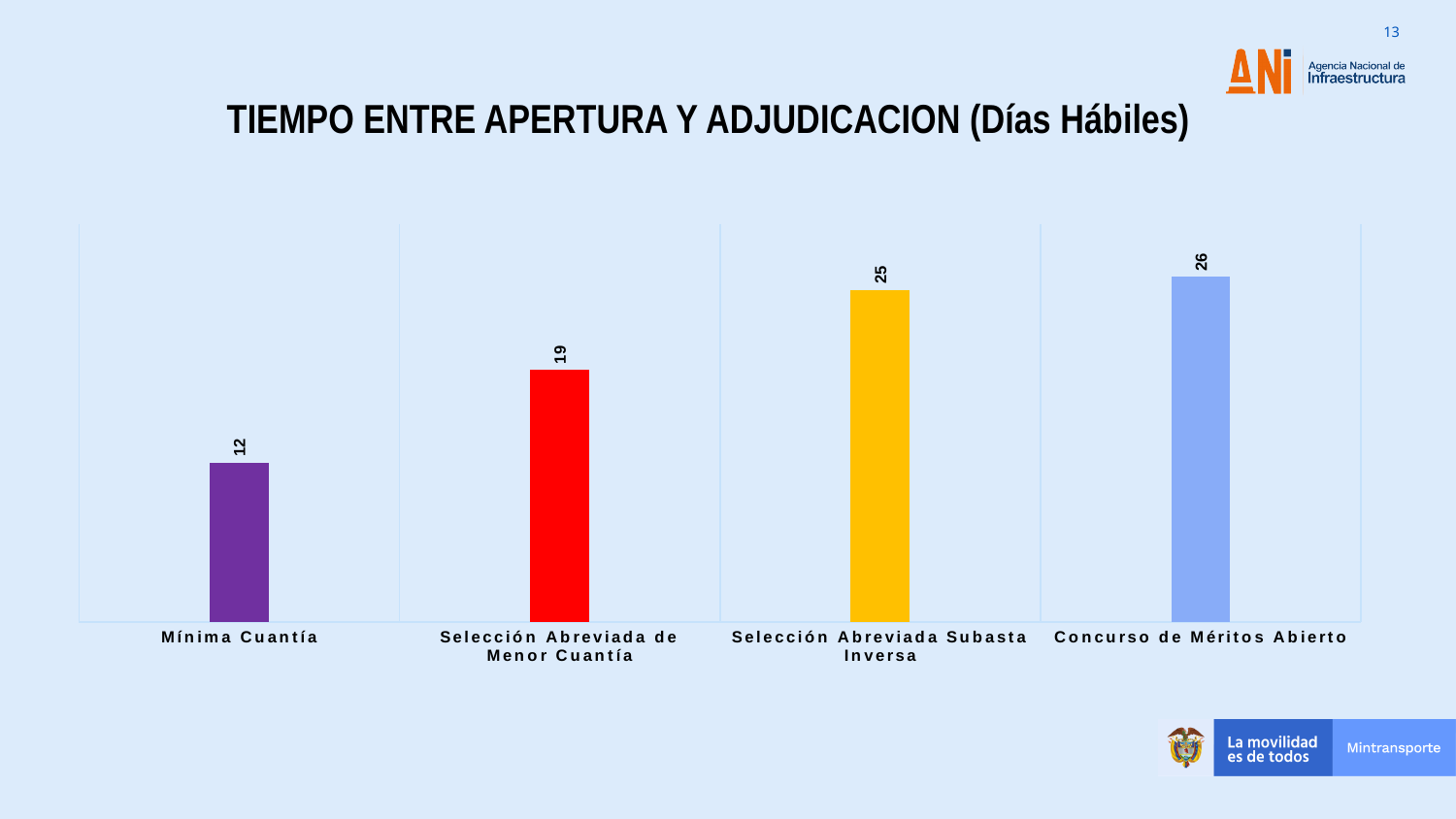
What is the value for Concurso de Méritos Abierto? 26 Which is larger, the value for Selección Abreviada de Menor Cuantía or the value for Mínima Cuantía? Selección Abreviada de Menor Cuantía What is the difference between the values for Concurso de Méritos Abierto and Selección Abreviada de Menor Cuantía? 7 Which category has the lowest value? Mínima Cuantía Do the values rise or fall from left to right across the categories? Rise What kind of chart is shown on the slide? Bar chart How many categories are shown in the chart? 4 What is the difference between the values for Selección Abreviada Subasta Inversa and Mínima Cuantía? 13 Which category has the highest value? Concurso de Méritos Abierto What is the value for Mínima Cuantía? 12 What is the value for Selección Abreviada Subasta Inversa? 25 What is the value for Selección Abreviada de Menor Cuantía? 19